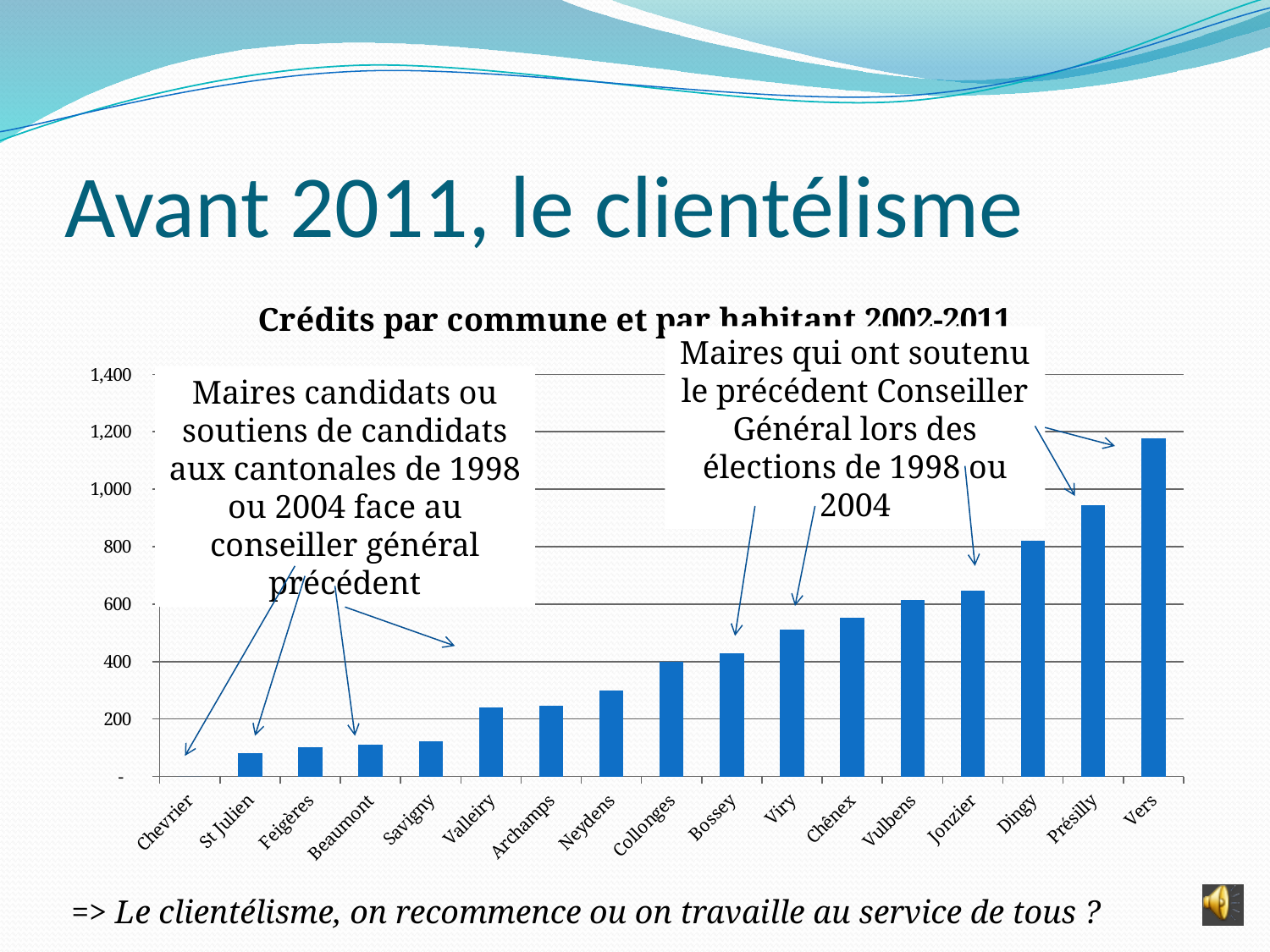
Is the value for Vers greater or less than 1,000? greater Is the value for Savigny greater or less than 200? less Which commune has the lowest value in the chart? Chevrier Is the value for Neydens greater or less than 200? greater Which has a larger value, Dingy or Viry? Dingy Do the values generally rise or fall from left to right along the x axis? rise What type of chart is shown on the slide? bar chart What is the title of the chart? Crédits par commune et par habitant 2002-2011 How many communes are shown on the x axis of the chart? 17 Which commune has the highest value in the chart? Vers